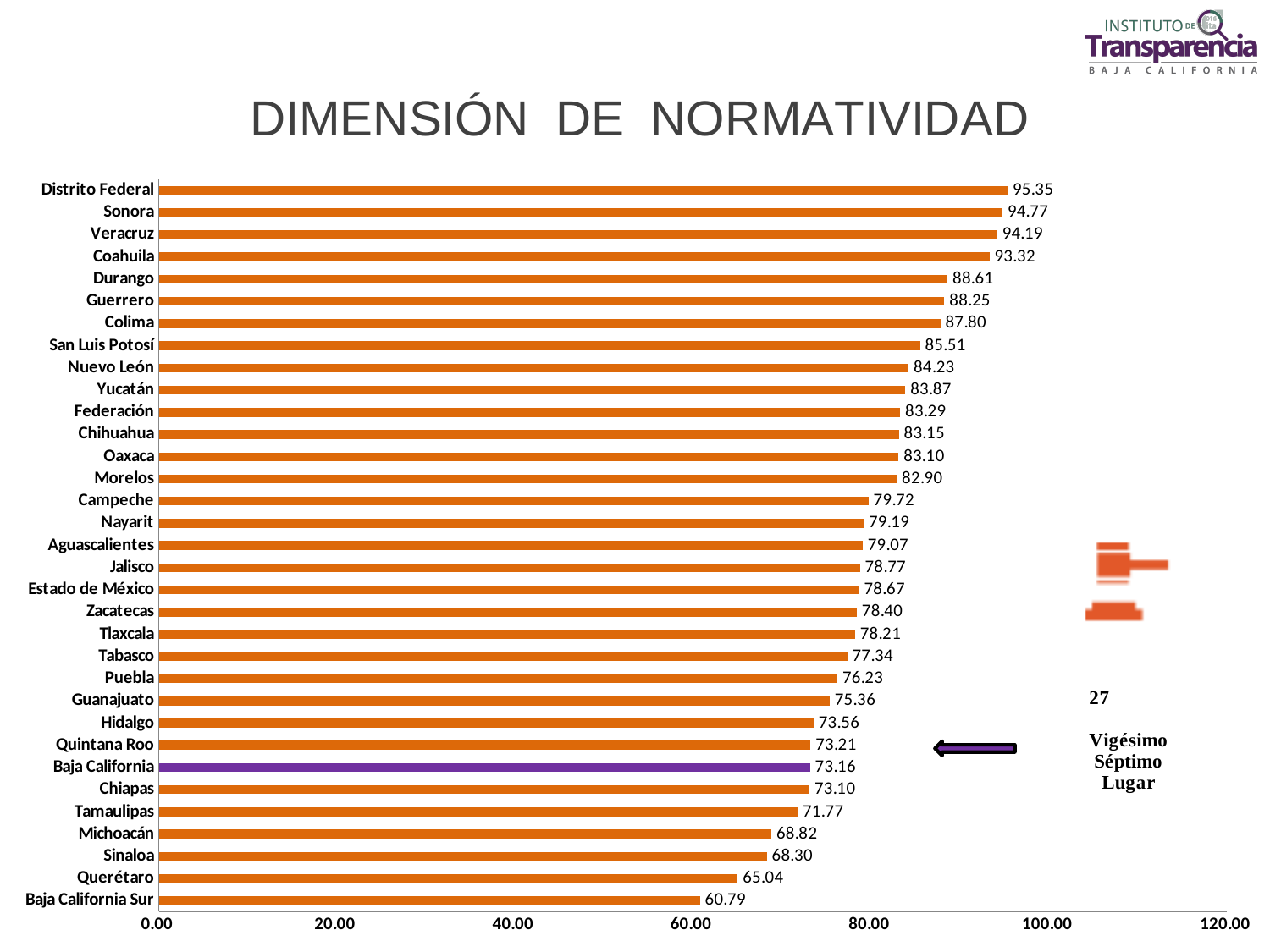
Is the value for Michoacán greater or less than 80.00? less What is the difference between the values for Campeche and Nayarit? 0.53 What is the value for Querétaro? 65.04 What is the value for Baja California? 73.16 How many categories are shown in the chart? 33 What is the value for Durango? 88.61 What kind of chart is shown on the slide? bar chart Which category has the highest value? Distrito Federal Which has a larger value, Colima or Hidalgo? Colima What is the difference between the values for Distrito Federal and Baja California Sur? 34.56 What is the title of the slide? DIMENSIÓN DE NORMATIVIDAD Which category has the lowest value? Baja California Sur